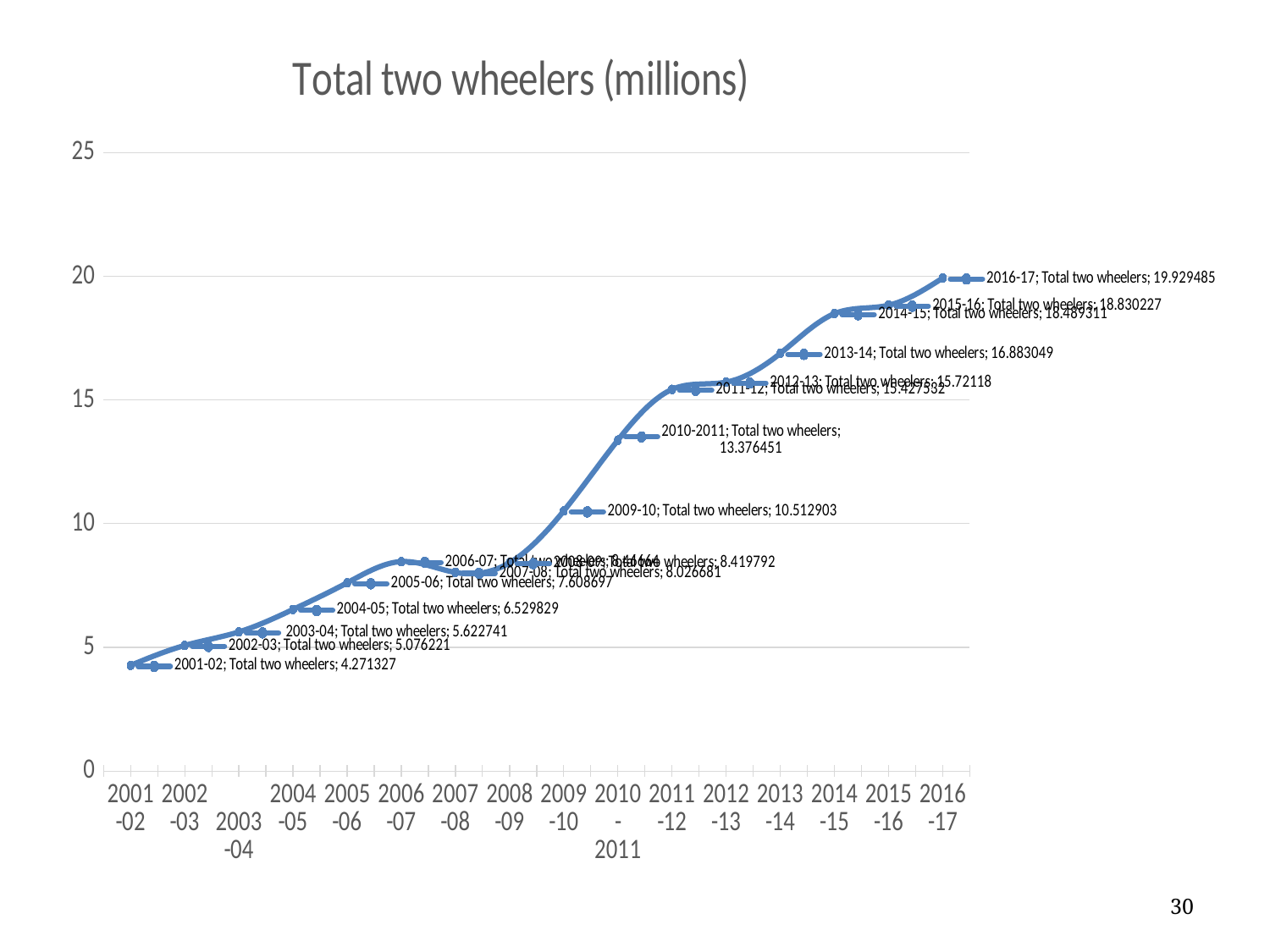
Is the value for 2010-2011 greater or less than 15? less What is the value for 2001-02? 4.271327 Which is larger, the value for 2004-05 or the value for 2005-06? 2005-06 What is the difference between the values for 2016-17 and 2015-16? 1.099258 What is the title of the chart? Total two wheelers (millions) Which year has the lowest value? 2001-02 What is the value for 2016-17? 19.929485 What is the value for 2009-10? 10.512903 Which year has the highest value? 2016-17 What is the value for 2013-14? 16.883049 What kind of chart is shown on the slide? line chart How many years are plotted on the x axis? 16